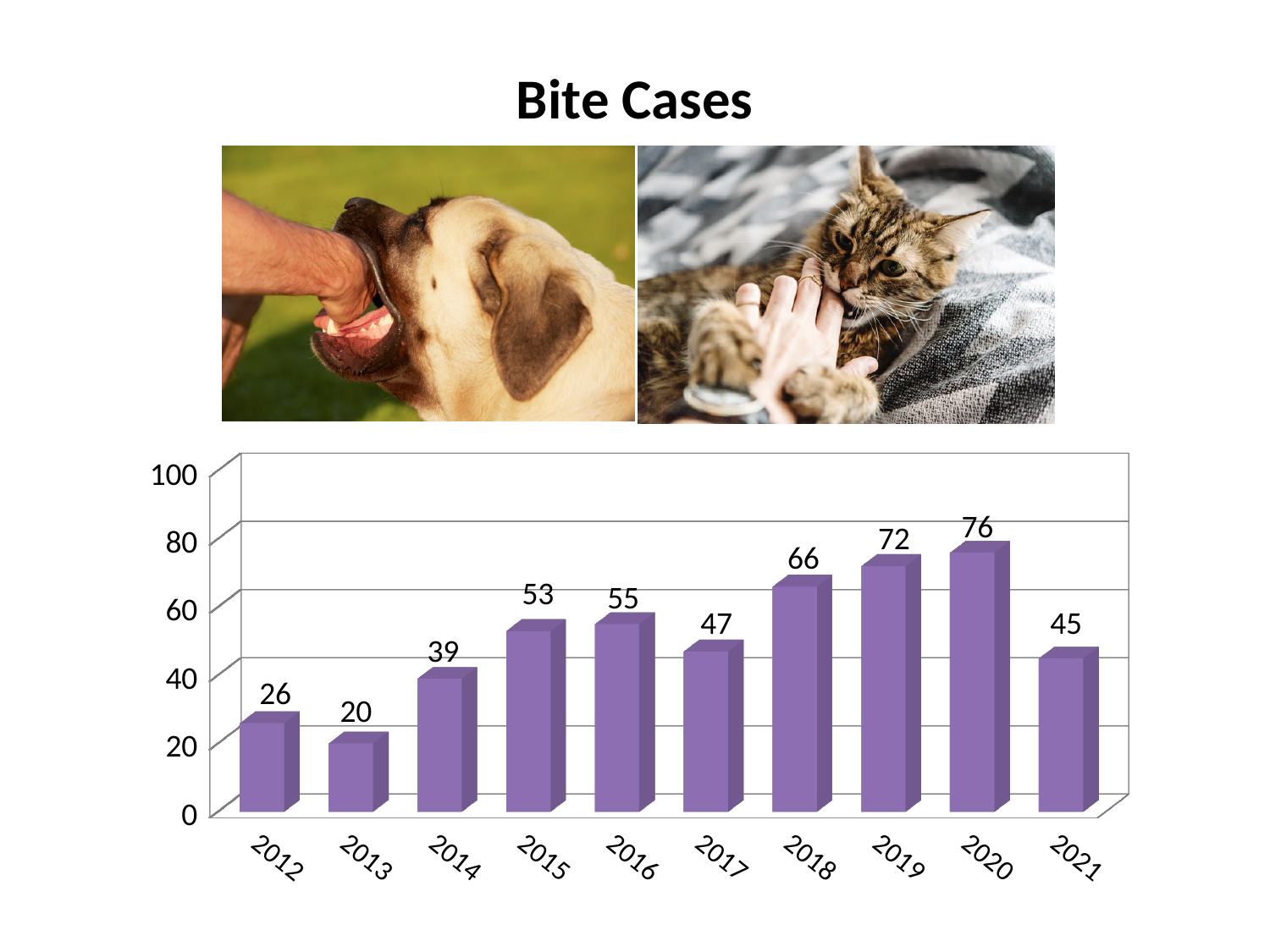
What is the difference between the values for 2014 and 2012? 13 What is the value for 2021? 45 Which year has the lowest value? 2013 Which is larger, the value for 2017 or the value for 2016? 2016 Is the value for 2018 greater or less than 60? greater What is the value for 2015? 53 What is the value for 2013? 20 What is the difference between the values for 2020 and 2021? 31 What kind of chart is shown on the slide? bar chart What is the title of the slide containing the chart? Bite Cases Which year has the highest value? 2020 How many years are shown on the x axis? 10